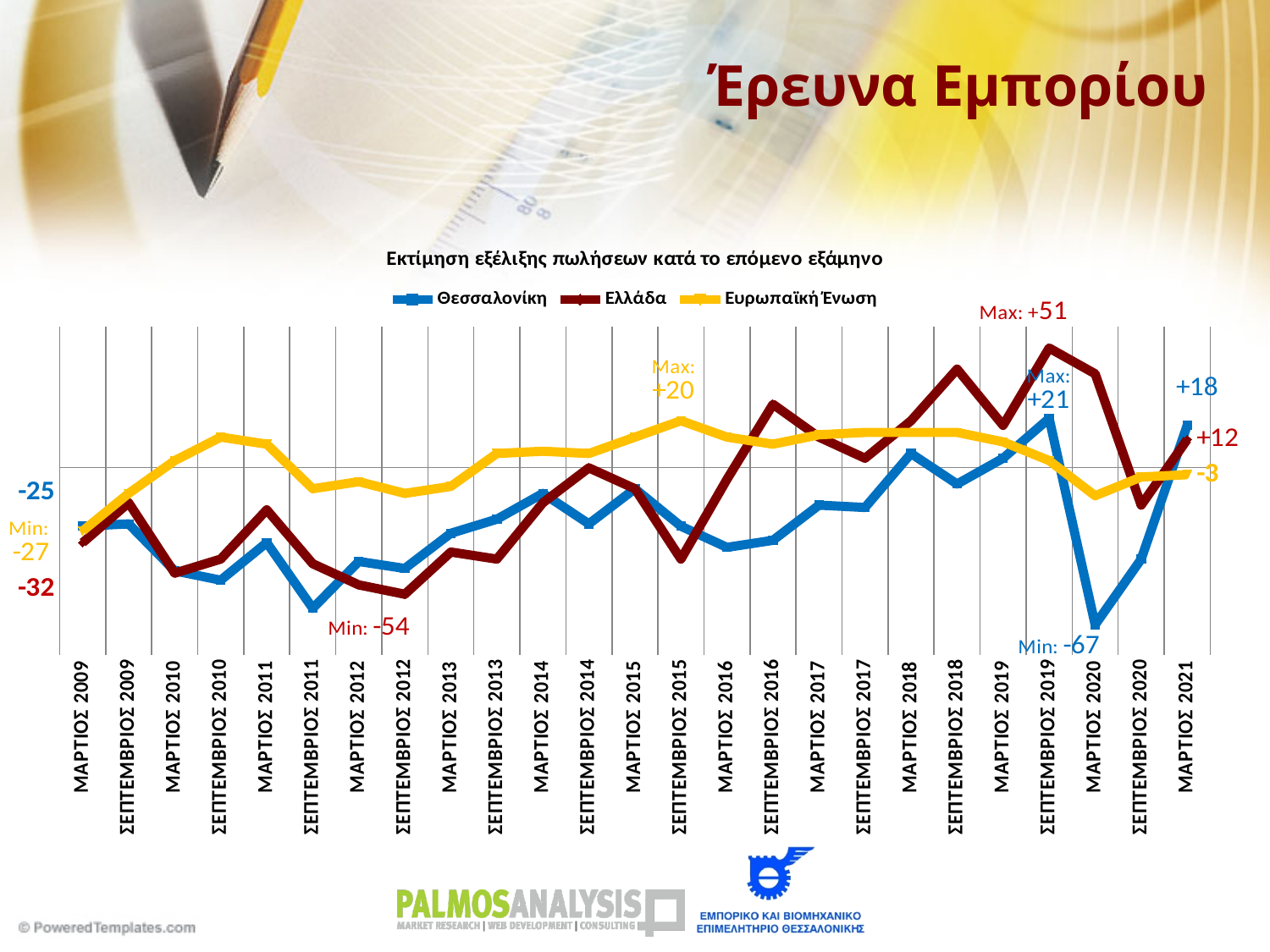
What kind of chart is shown on the slide? line chart What is the value for Ελλάδα in ΜΑΡΤΙΟΣ 2021? +12 In ΜΑΡΤΙΟΣ 2021, which series has the higher value, Θεσσαλονίκη or Ευρωπαϊκή Ένωση? Θεσσαλονίκη What is the value for Ευρωπαϊκή Ένωση in ΜΑΡΤΙΟΣ 2009? -27 What is the difference between the ΜΑΡΤΙΟΣ 2021 values for Θεσσαλονίκη and Ελλάδα? 6 What is the minimum value reached by the Ελλάδα series? -54 How many series does the legend list? 3 How many time points are shown on the x axis? 25 What is the title of the chart? Εκτίμηση εξέλιξης πωλήσεων κατά το επόμενο εξάμηνο What is the minimum value reached by the Θεσσαλονίκη series? -67 What is the value for Θεσσαλονίκη in ΜΑΡΤΙΟΣ 2021? +18 What is the maximum value reached by the Ελλάδα series? +51